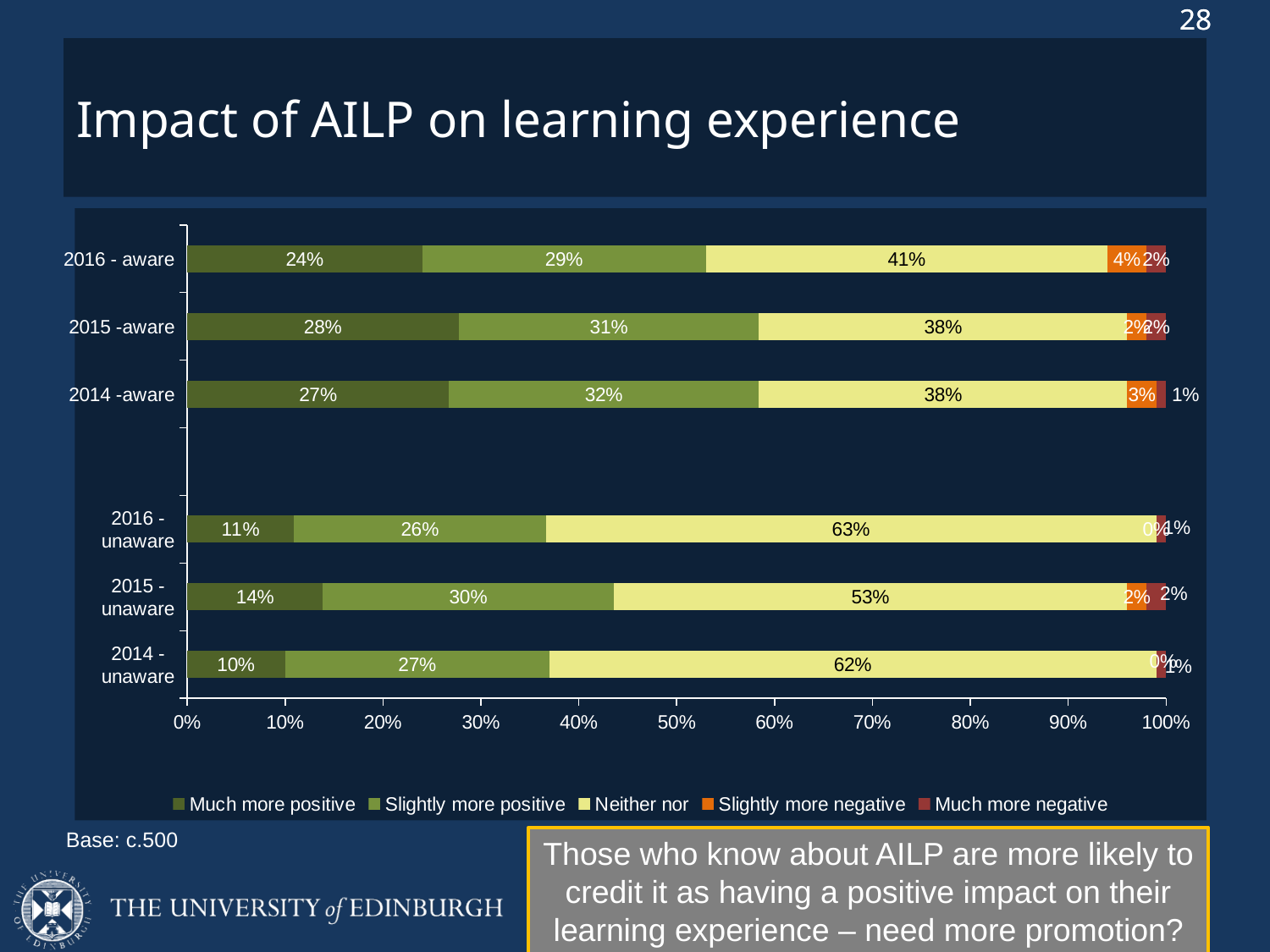
How many categories (bars) are plotted on the chart? 6 What is the 'Much more positive' value for 2015 -aware? 28% What is the 'Neither nor' value for 2016 - unaware? 63% Which category has the highest 'Neither nor' value? 2016 - unaware Which category has the lowest 'Much more positive' value? 2014 - unaware What is the 'Slightly more positive' value for 2015 - unaware? 30% What is the title of the chart on the slide? Impact of AILP on learning experience Which is larger: the 'Neither nor' value for 2016 - aware or for 2015 -aware? 2016 - aware What kind of chart is shown on the slide? Stacked bar chart What is the 'Slightly more negative' value for 2016 - aware? 4% How many series does the legend list? 5 What is the difference between the 'Much more positive' values for 2016 - aware and 2016 - unaware? 13 percentage points